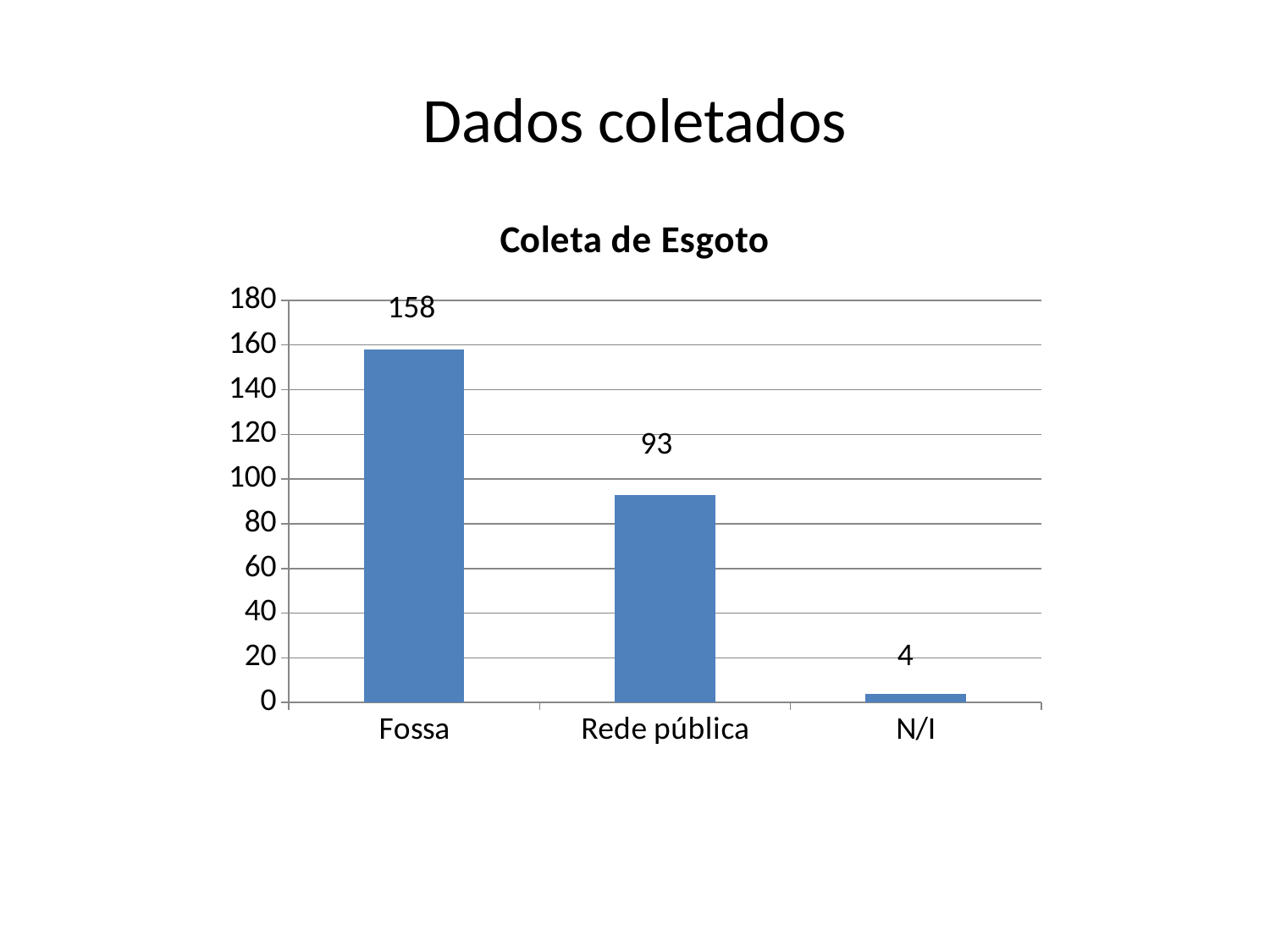
What is the title of the chart? Coleta de Esgoto How many categories are shown on the x axis? 3 Which is larger, the value for Fossa or the value for Rede pública? Fossa What is the difference between the values for Fossa and Rede pública? 65 What is the value for N/I? 4 Which category has the lowest value? N/I What kind of chart is shown on the slide? bar chart What is the value for Fossa? 158 Which category has the highest value? Fossa Is the value for Rede pública greater or less than 100? less What is the value for Rede pública? 93 What is the difference between the values for Rede pública and N/I? 89